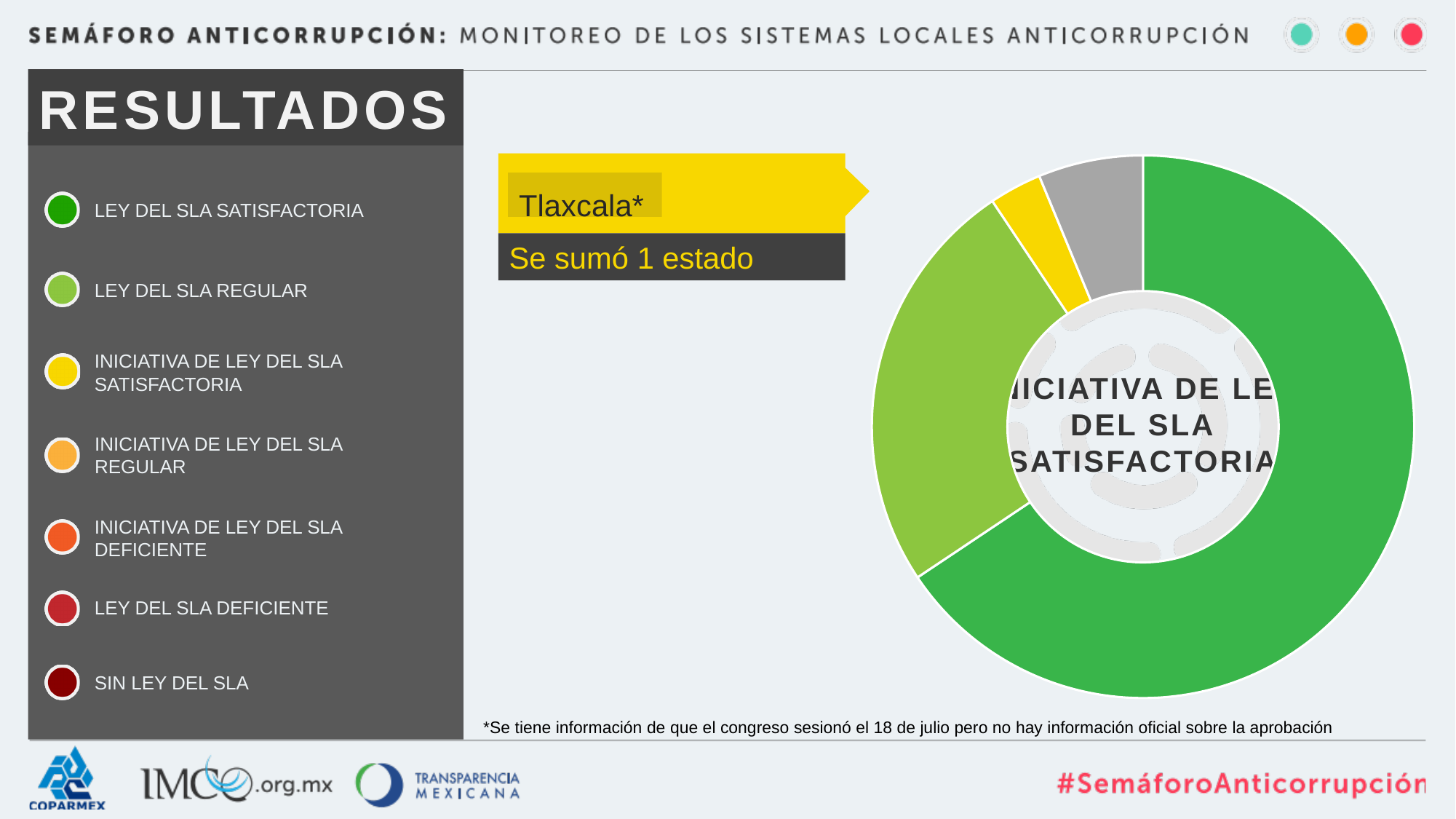
How many slices does the pie chart on the right contain? 4 What kind of chart is shown on the right side of the slide? doughnut chart Which category has the largest slice in the pie chart? LEY DEL SLA SATISFACTORIA In the pie chart, which slice is larger: the dark green (LEY DEL SLA SATISFACTORIA) or the light green (LEY DEL SLA REGULAR)? LEY DEL SLA SATISFACTORIA How many categories are listed in the legend on the left panel of the slide? 7 According to the callout next to the pie chart, how many states were added ("Se sumó")? 1 estado In the pie chart, which slice is larger: LEY DEL SLA REGULAR or INICIATIVA DE LEY DEL SLA SATISFACTORIA? LEY DEL SLA REGULAR Which state is named in the yellow callout next to the pie chart? Tlaxcala* Does the dark green slice (LEY DEL SLA SATISFACTORIA) take up more or less than half of the pie chart? more